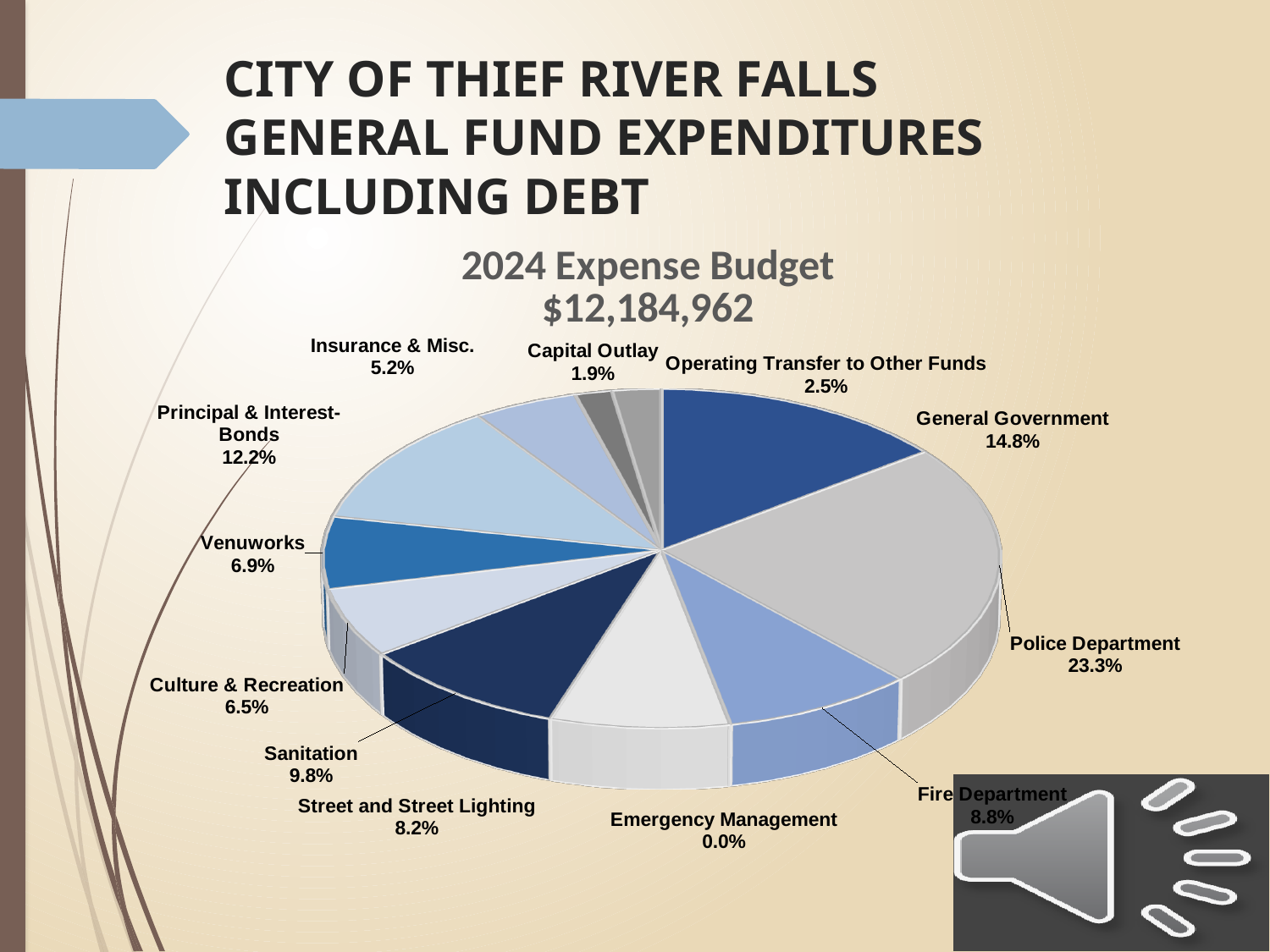
What percentage of the budget is allocated to Sanitation? 9.8% Which category has the smallest share of the budget? Emergency Management Which category has the largest share of the 2024 Expense Budget? Police Department What is the title of the chart? 2024 Expense Budget $12,184,962 What share of the 2024 Expense Budget goes to the Police Department? 23.3% Which has a larger share, Venuworks or Culture & Recreation? Venuworks What kind of chart is shown on the slide? Pie chart What percentage is shown for Emergency Management? 0.0% How many categories are shown in the pie chart? 12 What is the combined share of Capital Outlay and Operating Transfer to Other Funds? 4.4% What is the share for Principal & Interest-Bonds? 12.2% What is the difference in percentage points between the Police Department and General Government shares? 8.5